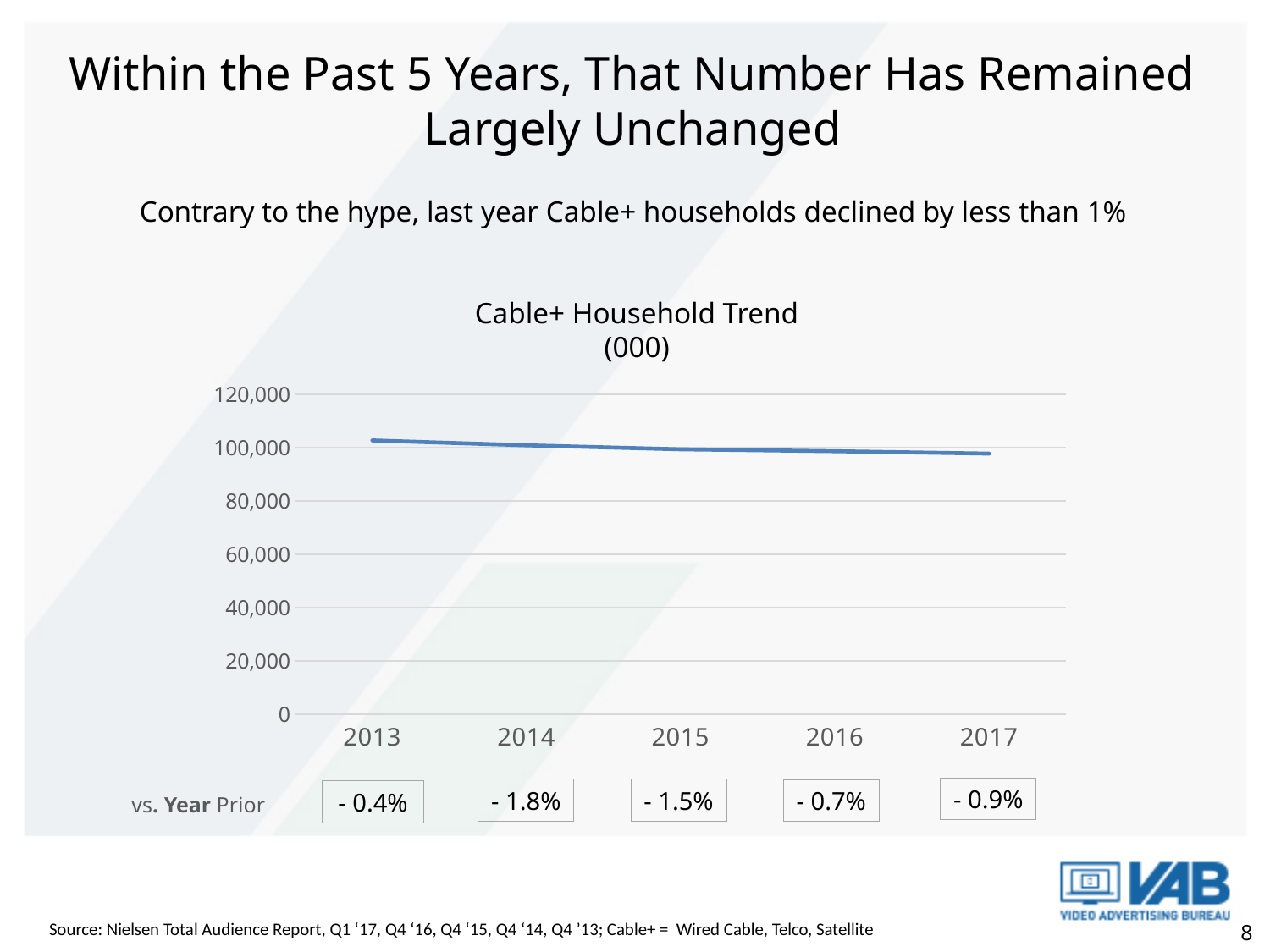
Which year has the highest value in the chart? 2013 Which year has the lowest value in the chart? 2017 What kind of chart is shown on the slide? line chart How many years are plotted on the x axis of the chart? 5 Is the value for 2013 greater or less than 120,000? less Do the values in the chart rise or fall from 2013 to 2017? fall Is the value for 2017 greater or less than 80,000? greater Is the value for 2015 greater or less than 60,000? greater What is the highest value shown on the y axis of the chart? 120,000 Which is larger, the value for 2013 or the value for 2017? 2013 What is the title of the chart? Cable+ Household Trend (000)